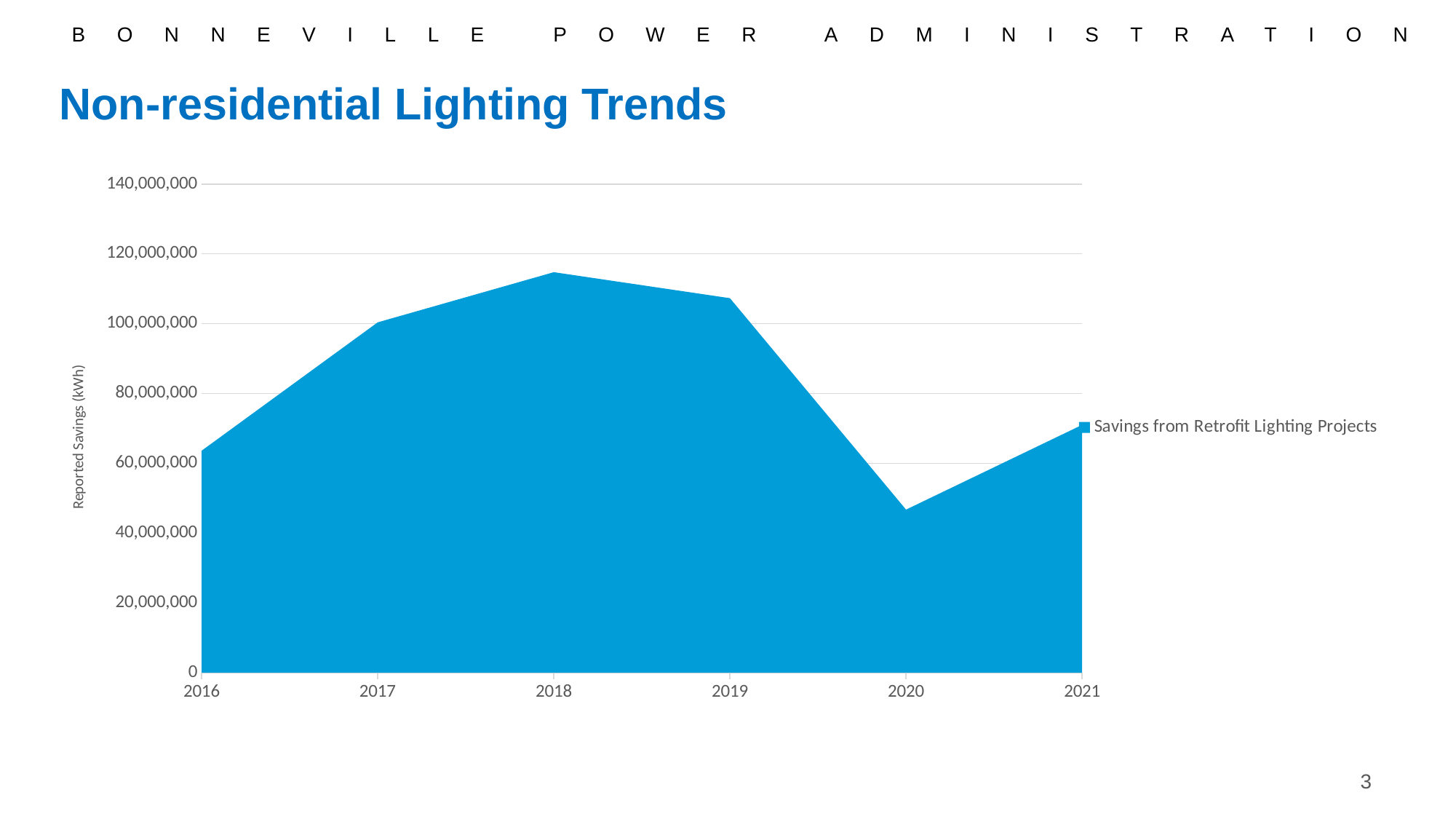
Which year has the lowest reported savings? 2020 Is the value for 2018 greater or less than 100,000,000? greater What kind of chart is shown on the slide? Area chart Do the reported savings rise or fall from 2019 to 2020? fall Is the value for 2020 greater or less than 60,000,000? less How many years are plotted along the x axis? 6 What is the label of the series shown in the legend? Savings from Retrofit Lighting Projects Which year has the highest reported savings? 2018 What is the title of the vertical axis? Reported Savings (kWh) How many series does the legend list? 1 Is the value for 2016 greater or less than 80,000,000? less Which year has the larger value, 2019 or 2021? 2019